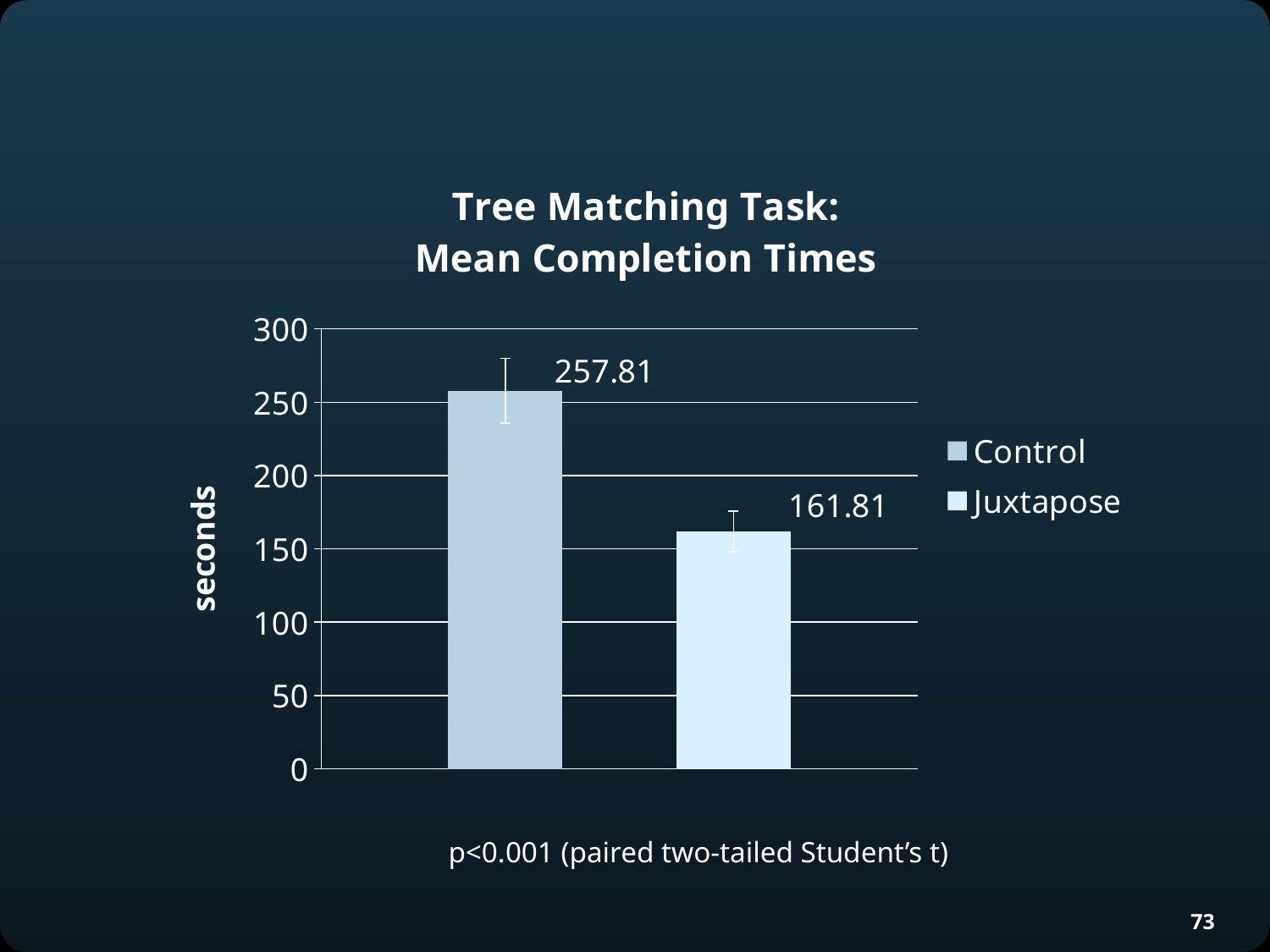
Which condition has the lower mean completion time? Juxtapose How many bars are plotted in the chart? 2 What is the title of the chart? Tree Matching Task: Mean Completion Times What kind of chart is shown? bar chart How many series does the legend list? 2 Is the value for Juxtapose greater or less than 200? less What is the difference between the Control and Juxtapose mean completion times? 96 What is the label on the vertical axis? seconds What is the mean completion time for Juxtapose? 161.81 Is the value for Control greater or less than 250? greater What is the mean completion time for Control? 257.81 Which condition has the higher mean completion time? Control